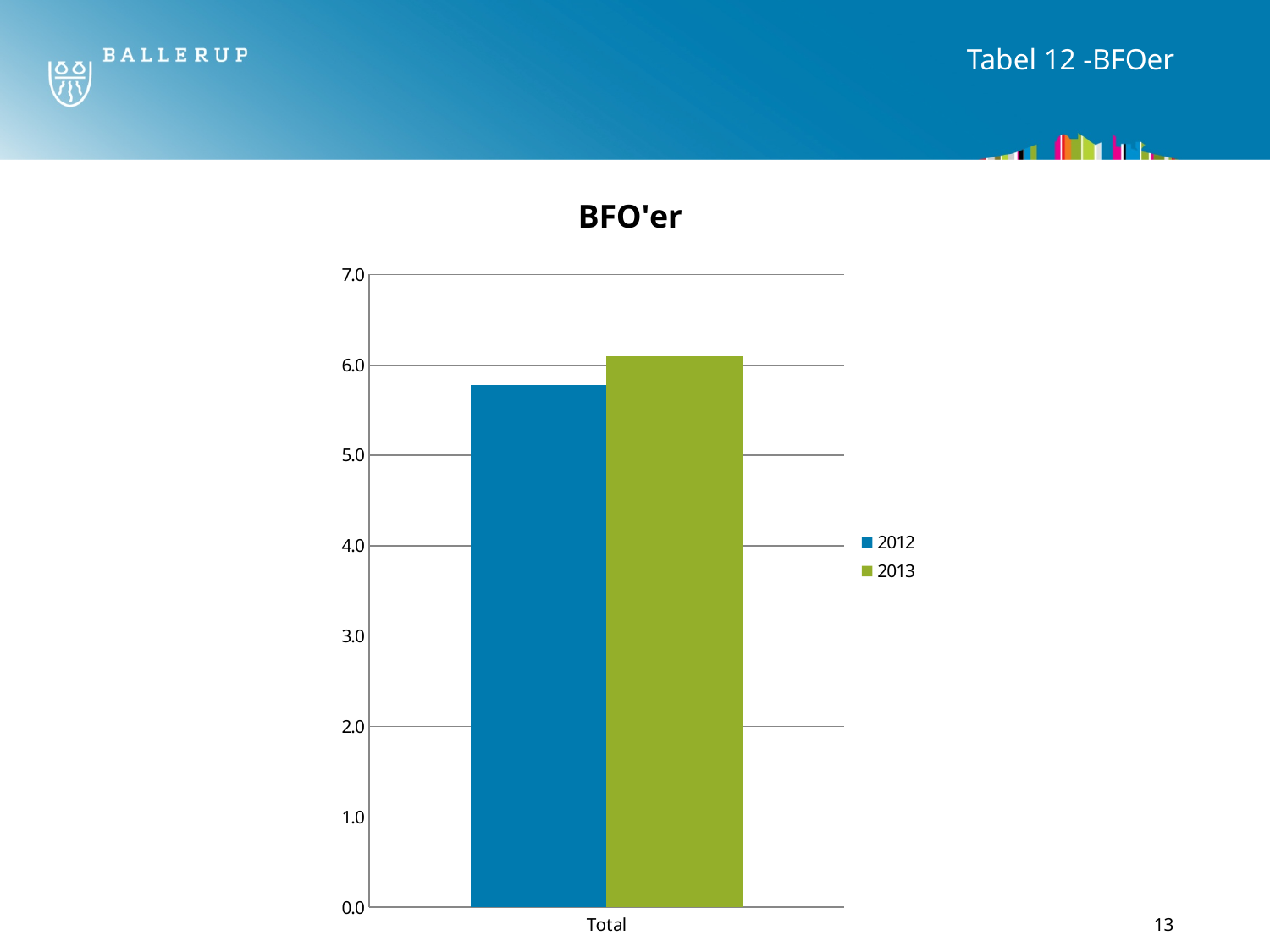
Is the value for 2012 greater or less than 5.0? greater Which series has the higher value for Total, 2012 or 2013? 2013 Is the value for 2013 greater or less than 5.0? greater Which series has the lowest value in the chart? 2012 Which years are listed in the legend? 2012 and 2013 What is the title of the chart? BFO'er How many series does the legend list? 2 Is the value for 2012 greater or less than 6.0? less How many categories are shown on the x axis? 1 What kind of chart is shown on the slide? bar chart What is the label of the category on the x axis? Total